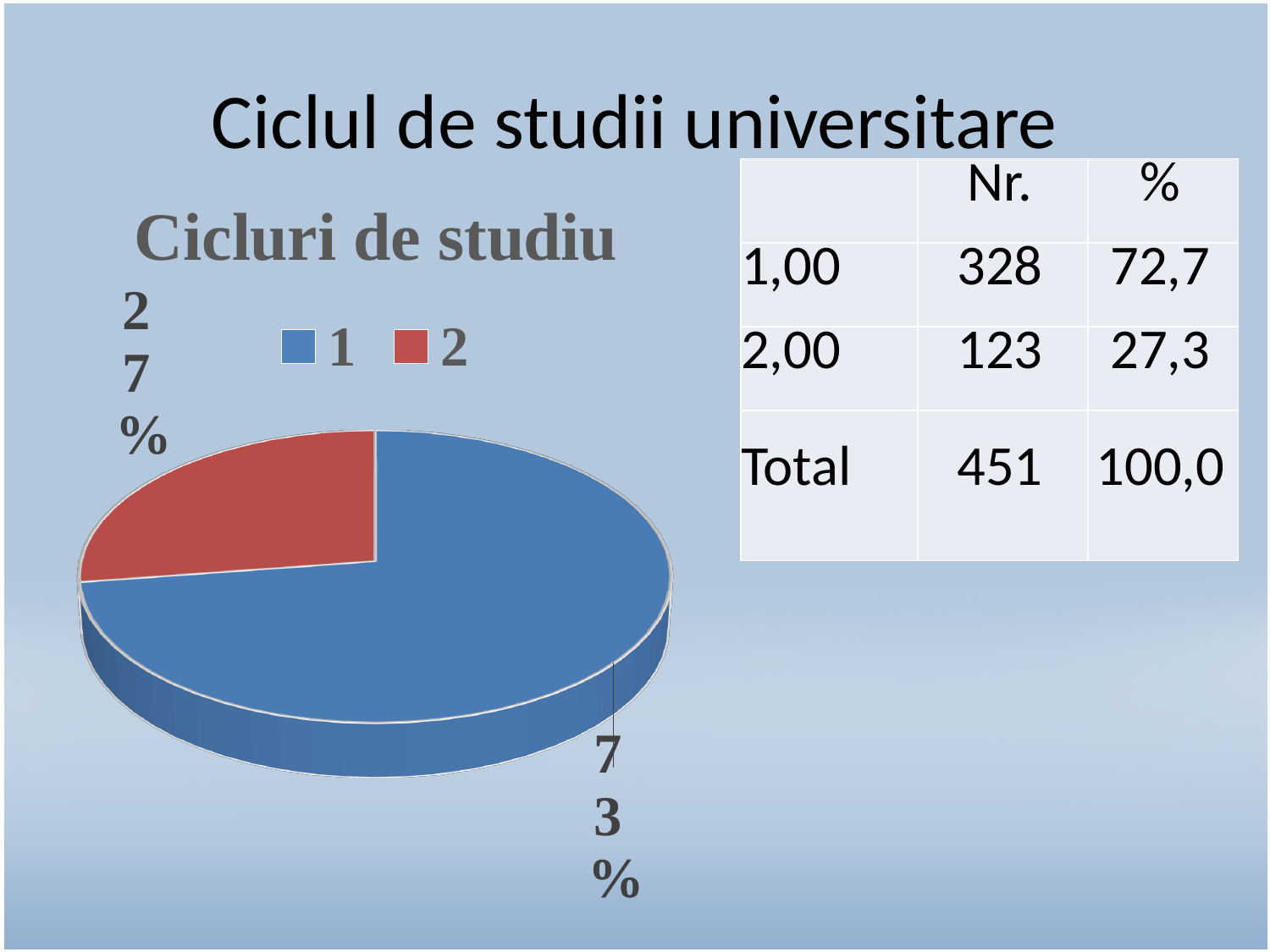
How many entries does the chart legend list? 2 Which slice of the pie chart is the smallest? 2 Which slice of the pie chart is the largest? 1 What is the difference in percentage points between slice 1 and slice 2 in the pie chart? 46 What percentage is shown for slice 2 in the pie chart? 27% What is the title of the chart? Cicluri de studiu What percentage is shown for slice 1 in the pie chart? 73% What kind of chart is shown on the slide? pie chart Which is larger in the pie chart, slice 1 or slice 2? 1 What colour is slice 2 in the pie chart? red How many slices does the pie chart have? 2